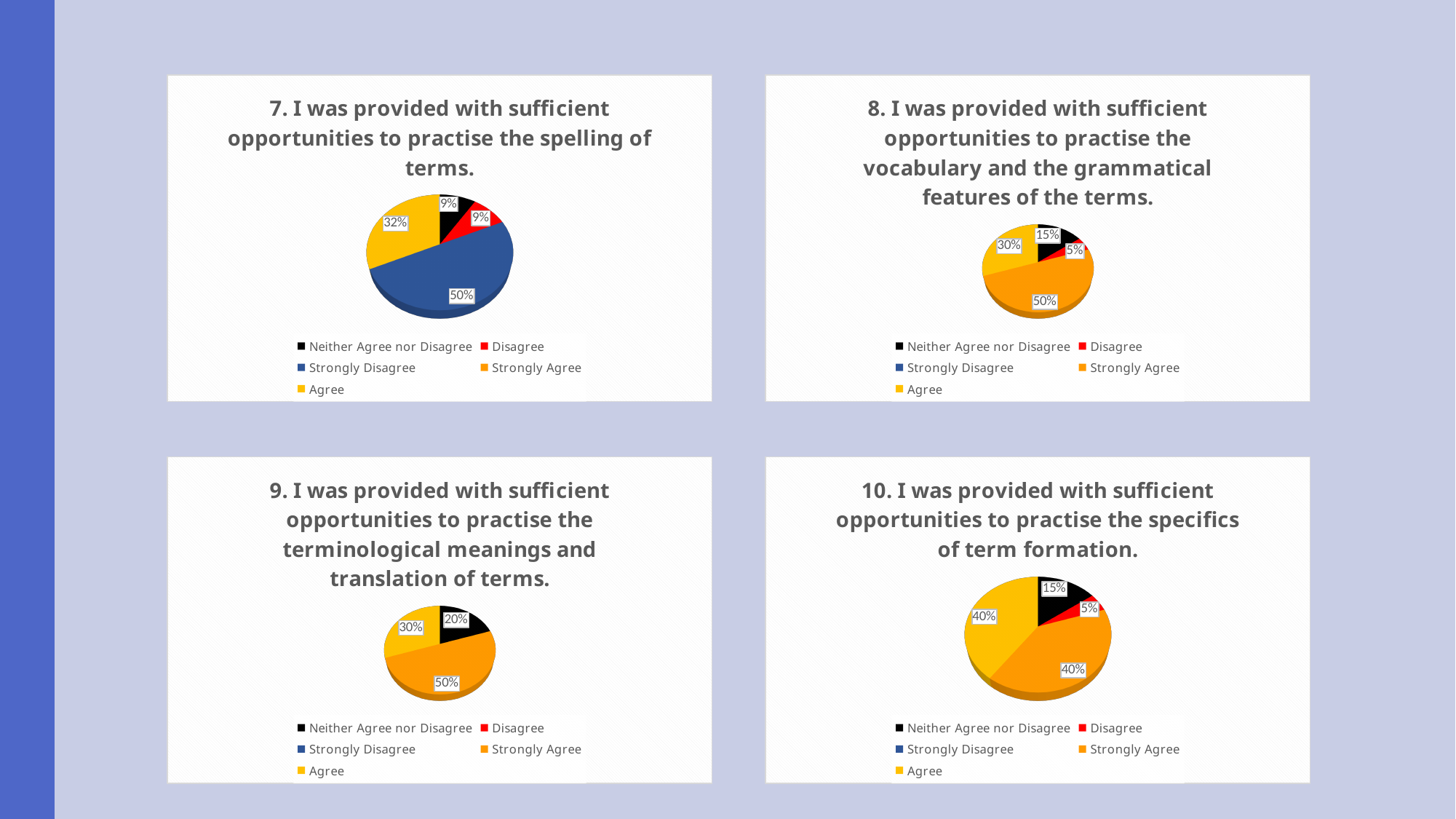
What kind of chart is used in the chart titled '10. I was provided with sufficient opportunities to practise the specifics of term formation.'? Pie chart How many entries does the legend list in the chart titled '7. I was provided with sufficient opportunities to practise the spelling of terms.'? 5 In the chart titled '9. I was provided with sufficient opportunities to practise the terminological meanings and translation of terms.', which is larger, the Strongly Agree slice or the Agree slice? Strongly Agree In the chart titled '10. I was provided with sufficient opportunities to practise the specifics of term formation.', what percentage is labelled for the Agree slice? 40% In the chart titled '8. I was provided with sufficient opportunities to practise the vocabulary and the grammatical features of the terms.', what is the difference between the Strongly Agree and Agree percentages? 20% In the chart titled '7. I was provided with sufficient opportunities to practise the spelling of terms.', which response has the largest slice? Strongly Disagree In the chart titled '7. I was provided with sufficient opportunities to practise the spelling of terms.', what percentage is labelled for the Agree slice? 32% In the chart titled '9. I was provided with sufficient opportunities to practise the terminological meanings and translation of terms.', what percentage is labelled for the Neither Agree nor Disagree slice? 20% In the chart titled '7. I was provided with sufficient opportunities to practise the spelling of terms.', what percentage is labelled for the Strongly Disagree slice? 50% In the chart titled '8. I was provided with sufficient opportunities to practise the vocabulary and the grammatical features of the terms.', what percentage is labelled for the Disagree slice? 5% In the chart titled '10. I was provided with sufficient opportunities to practise the specifics of term formation.', what is the difference between the Neither Agree nor Disagree and Disagree percentages? 10% In the chart titled '8. I was provided with sufficient opportunities to practise the vocabulary and the grammatical features of the terms.', what percentage is labelled for the Strongly Agree slice? 50%